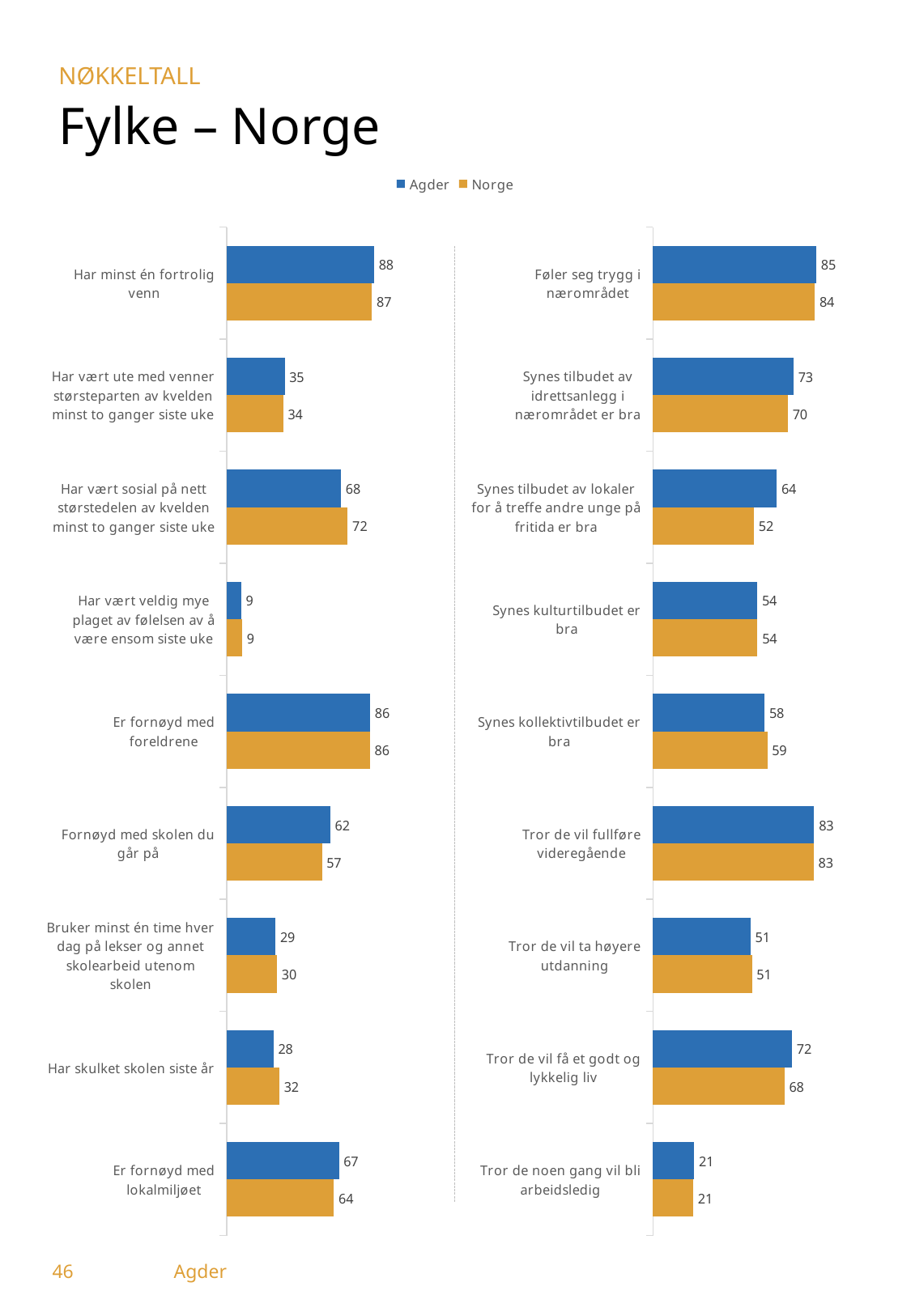
How many categories does the left chart show? 9 In the right chart, which category has the highest Norge value? Føler seg trygg i nærområdet In the left chart, what is the Agder value for "Har minst én fortrolig venn"? 88 In the right chart, what is the difference between the Agder and Norge values for "Synes tilbudet av lokaler for å treffe andre unge på fritida er bra"? 12 In the left chart, which is larger for "Har vært sosial på nett størstedelen av kvelden minst to ganger siste uke": Agder or Norge? Norge In the left chart, which category has the lowest Agder value? Har vært veldig mye plaget av følelsen av å være ensom siste uke In the right chart, what is the Norge value for "Synes tilbudet av lokaler for å treffe andre unge på fritida er bra"? 52 What kind of chart is the right chart? Bar chart In the right chart, which is larger for "Tror de vil få et godt og lykkelig liv": Agder or Norge? Agder Which colour represents Norge in the legend? Orange How many series does the legend list? 2 In the left chart, what is the difference between the Norge and Agder values for "Har skulket skolen siste år"? 4